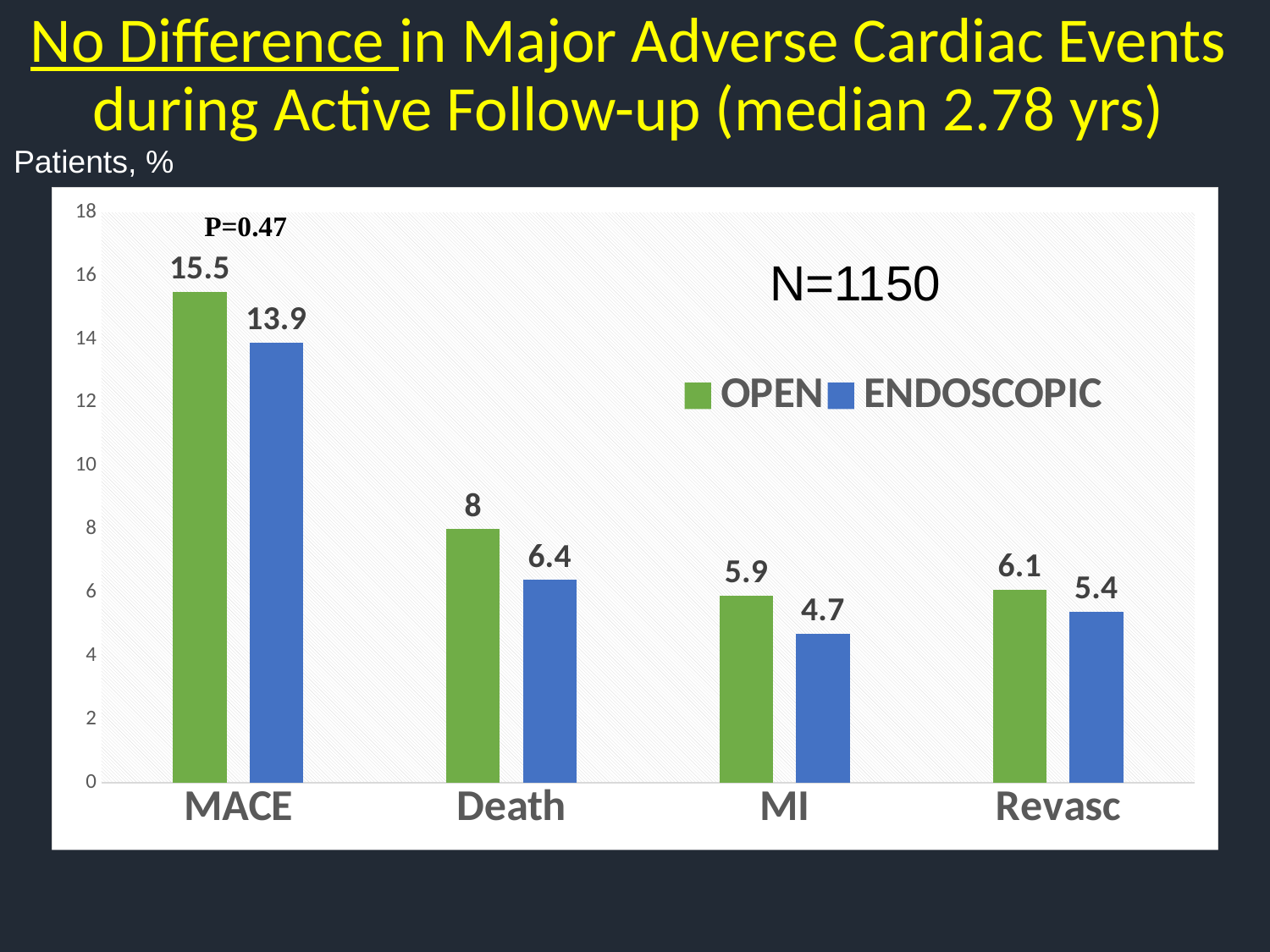
How many categories are shown on the x axis? 4 Which category has the highest value for the OPEN series? MACE What kind of chart is shown on the slide? Bar chart What is the value for OPEN in the MACE category? 15.5 Which category has the lowest value for the ENDOSCOPIC series? MI What P value is printed above the MACE bars? P=0.47 What is the value for ENDOSCOPIC in the MI category? 4.7 Which is larger in the Death category, OPEN or ENDOSCOPIC? OPEN How many series does the legend list? 2 What is the value for ENDOSCOPIC in the Death category? 6.4 What is the value for OPEN in the Revasc category? 6.1 What is the difference between the OPEN and ENDOSCOPIC values for MACE? 1.6